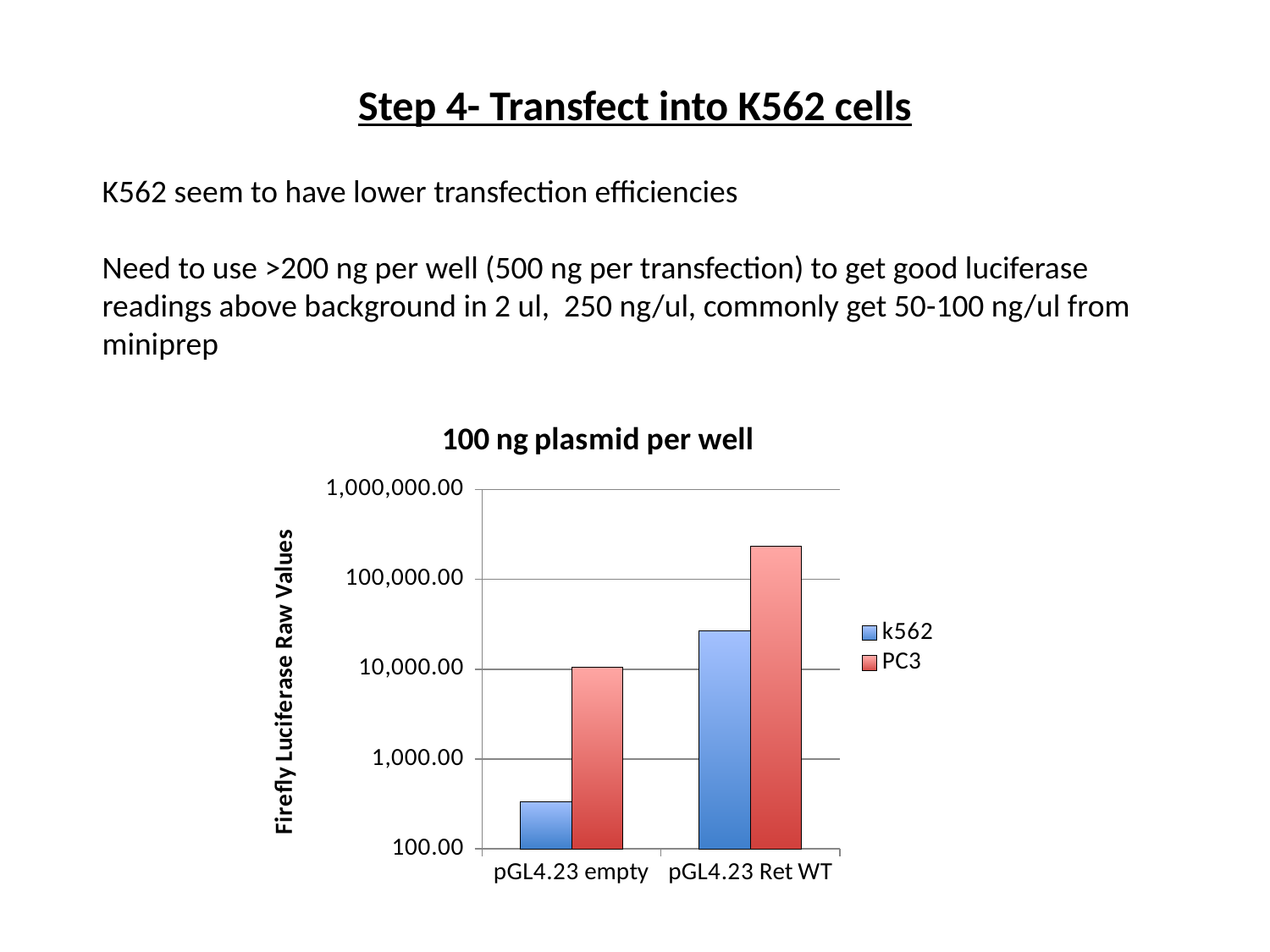
Do the k562 values rise or fall from pGL4.23 empty to pGL4.23 Ret WT? rise Is the k562 value for pGL4.23 empty greater or less than 1,000.00? less Is the PC3 value for pGL4.23 Ret WT greater or less than 100,000.00? greater For pGL4.23 Ret WT, which series has the larger value, k562 or PC3? PC3 Which bar in the chart is the lowest? k562 for pGL4.23 empty What is the label of the y axis of the chart? Firefly Luciferase Raw Values Is the k562 value for pGL4.23 Ret WT greater or less than 10,000.00? greater Which bar in the chart is the highest? PC3 for pGL4.23 Ret WT How many series does the chart legend list? 2 What type of chart is shown on the slide? bar chart How many categories are shown on the x axis of the chart? 2 What is the title of the chart? 100 ng plasmid per well